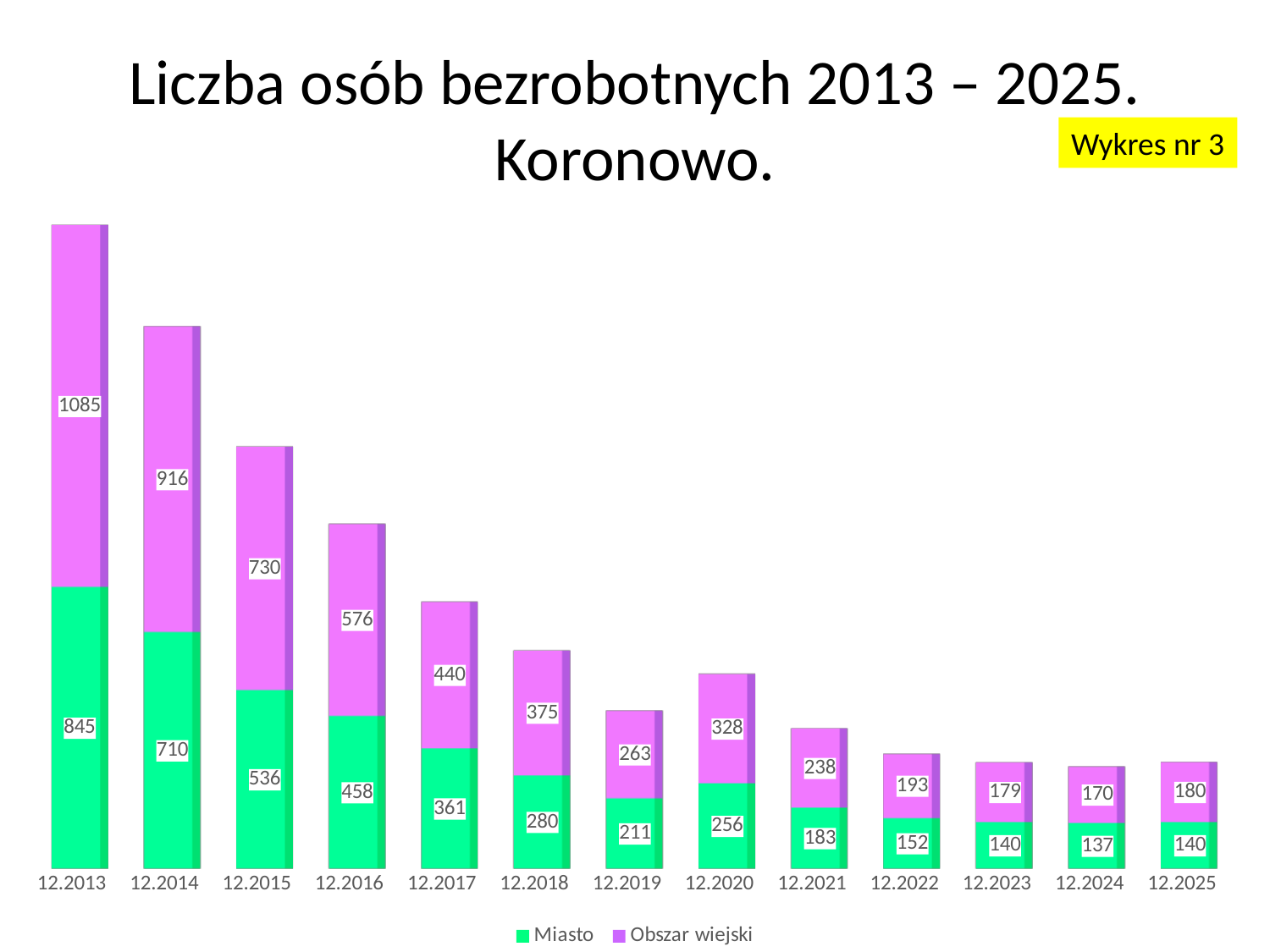
What is the value for Obszar wiejski in 12.2016? 576 Do the total values rise or fall from 12.2013 to 12.2025? Fall Which year has the highest value for Obszar wiejski? 12.2013 What is the total of the stacked bar for 12.2025? 320 What is the value for Miasto in 12.2024? 137 Which is larger: Miasto in 12.2019 or Miasto in 12.2020? Miasto in 12.2020 How many years are shown on the x axis? 13 Which year has the lowest value for Miasto? 12.2024 What kind of chart is this? Stacked bar chart What is the difference between the Obszar wiejski values in 12.2013 and 12.2014? 169 How many series does the legend list? 2 What is the value for Miasto in 12.2013? 845